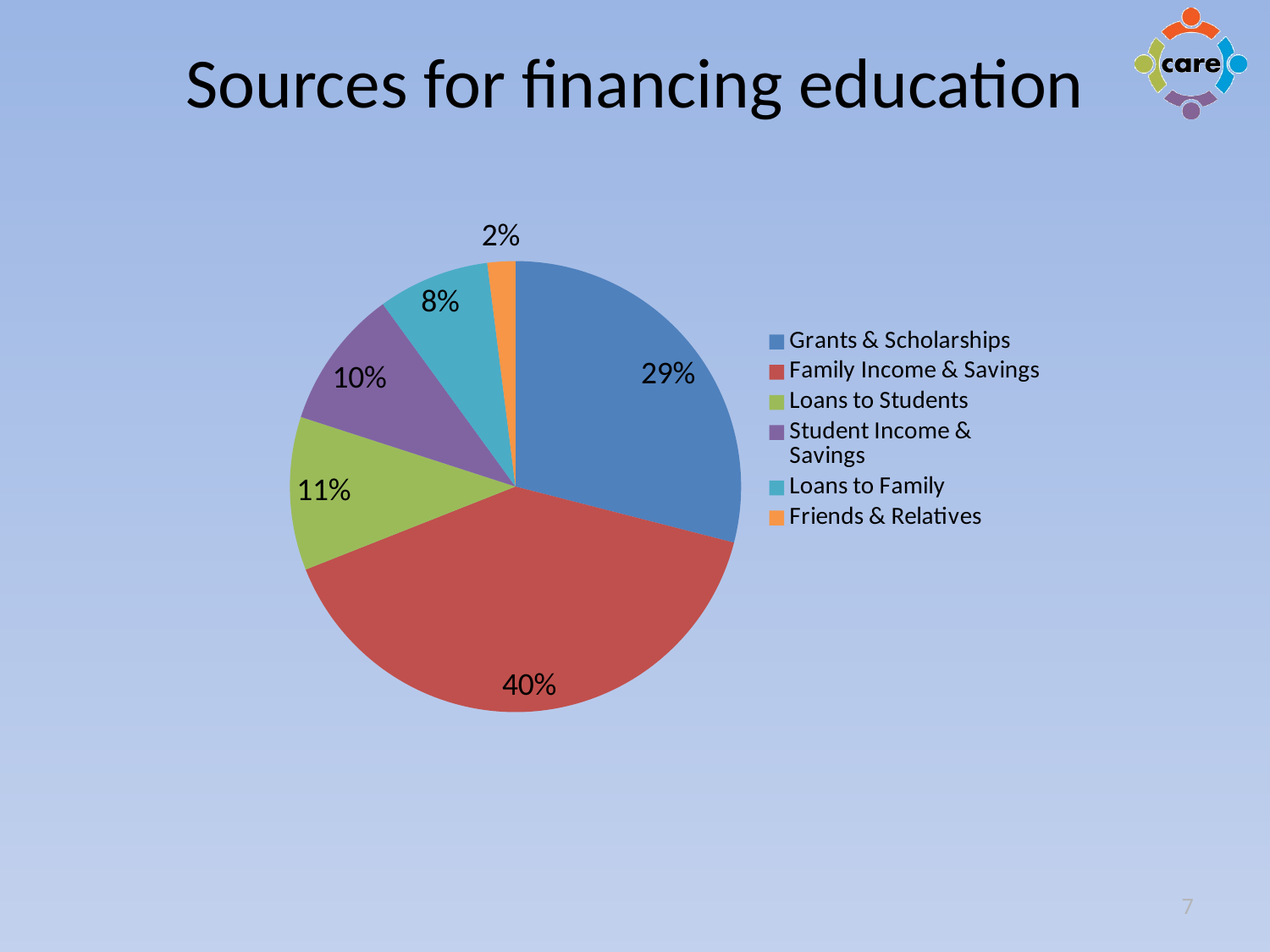
Which is larger, the share for Loans to Students or the share for Loans to Family? Loans to Students What is the value shown for Loans to Family? 8% Which source has the smallest share of the pie? Friends & Relatives What is the value shown for Friends & Relatives? 2% How many categories does the pie chart show? 6 What kind of chart is shown on the slide? Pie chart What is the difference between the shares for Family Income & Savings and Grants & Scholarships? 11% What is the value shown for Student Income & Savings? 10% What share of the pie does Grants & Scholarships represent? 29% What share of the pie does Family Income & Savings represent? 40% Which source has the largest share of the pie? Family Income & Savings What is the value shown for Loans to Students? 11%